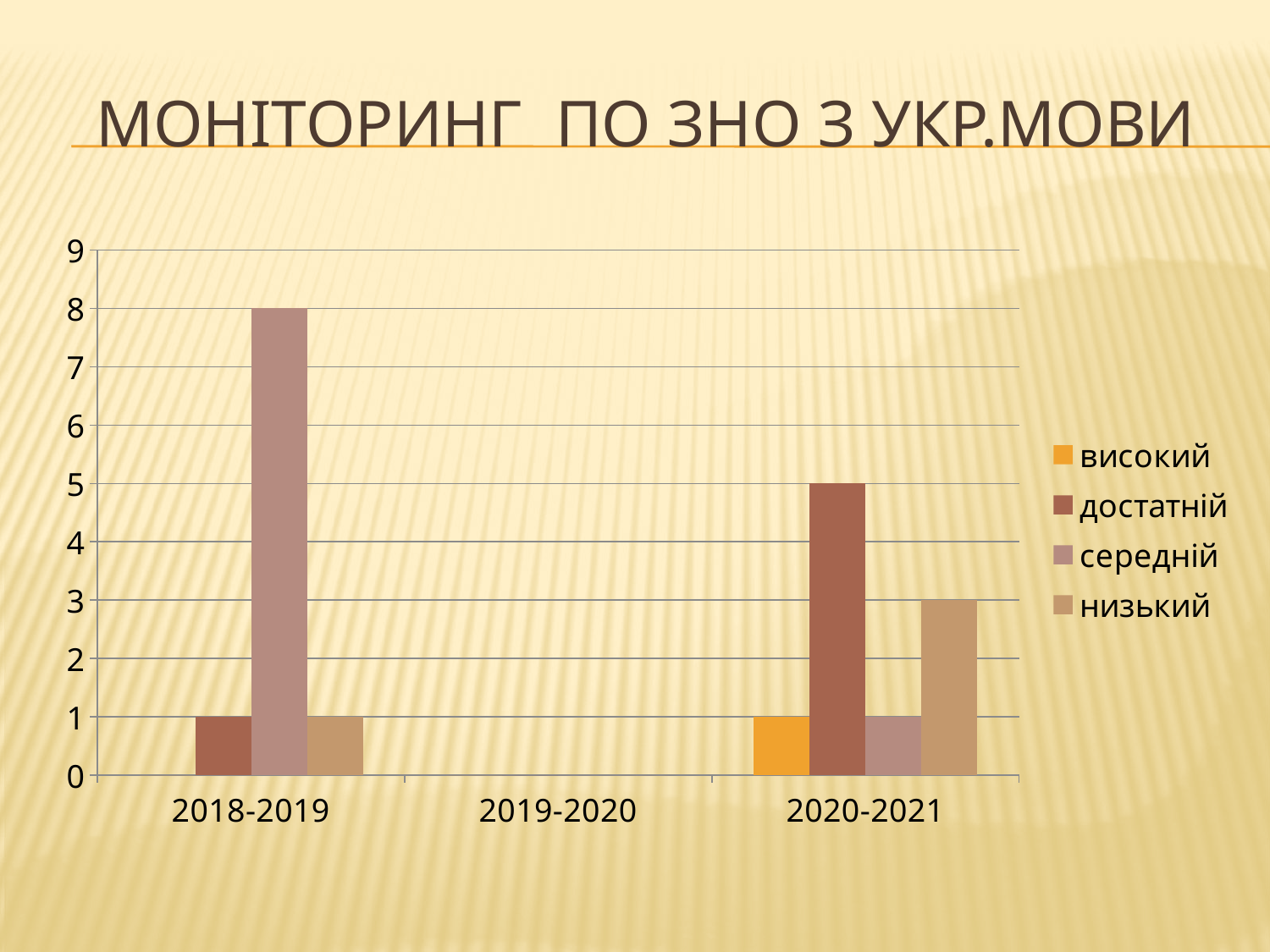
Which series has the highest value in 2020-2021? достатній What is the value for низький in 2020-2021? 3 What is the value for достатній in 2020-2021? 5 What is the value for високий in 2020-2021? 1 What kind of chart is shown on the slide? bar chart How many categories are shown on the x axis? 3 Which series has the highest value in 2018-2019? середній How many series does the legend list? 4 Which is larger: низький in 2020-2021 or низький in 2018-2019? низький in 2020-2021 What is the value for середній in 2018-2019? 8 What is the title of the chart on the slide? МОНІТОРИНГ ПО ЗНО З УКР.МОВИ What is the difference between середній in 2018-2019 and достатній in 2020-2021? 3